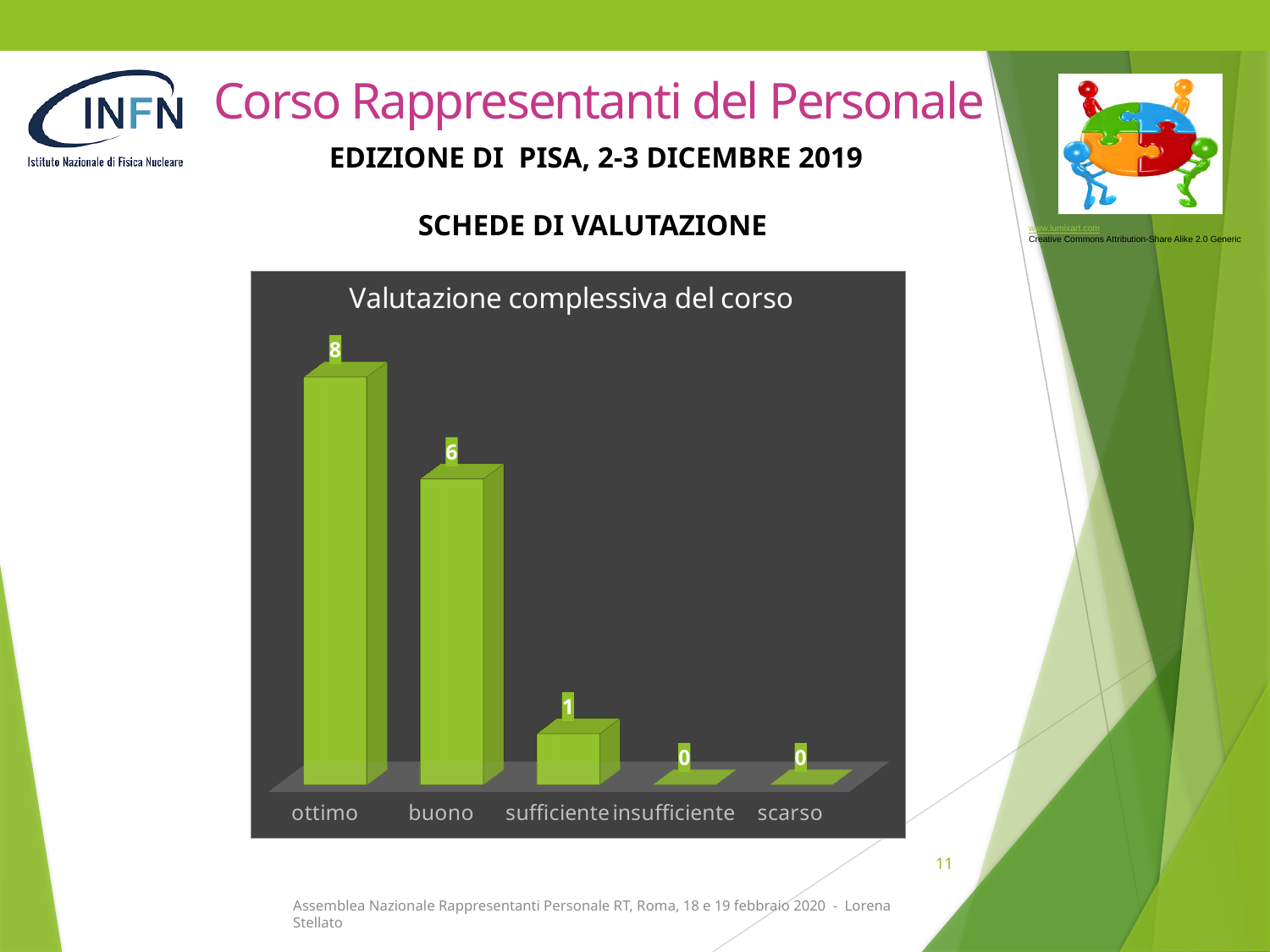
What is the difference between the values for "ottimo" and "buono"? 2 What is the title of the chart? Valutazione complessiva del corso Which category has the highest value in the chart? ottimo Which is larger, the value for "buono" or the value for "sufficiente"? buono What is the difference between the values for "buono" and "sufficiente"? 5 What is the value for "buono" in the chart? 6 What kind of chart is shown on the slide? bar chart Do the values rise or fall moving from left to right along the x axis? fall What is the value for "ottimo" in the chart? 8 What is the value for "sufficiente" in the chart? 1 What is the value for "insufficiente" in the chart? 0 How many categories are shown on the x axis of the chart? 5